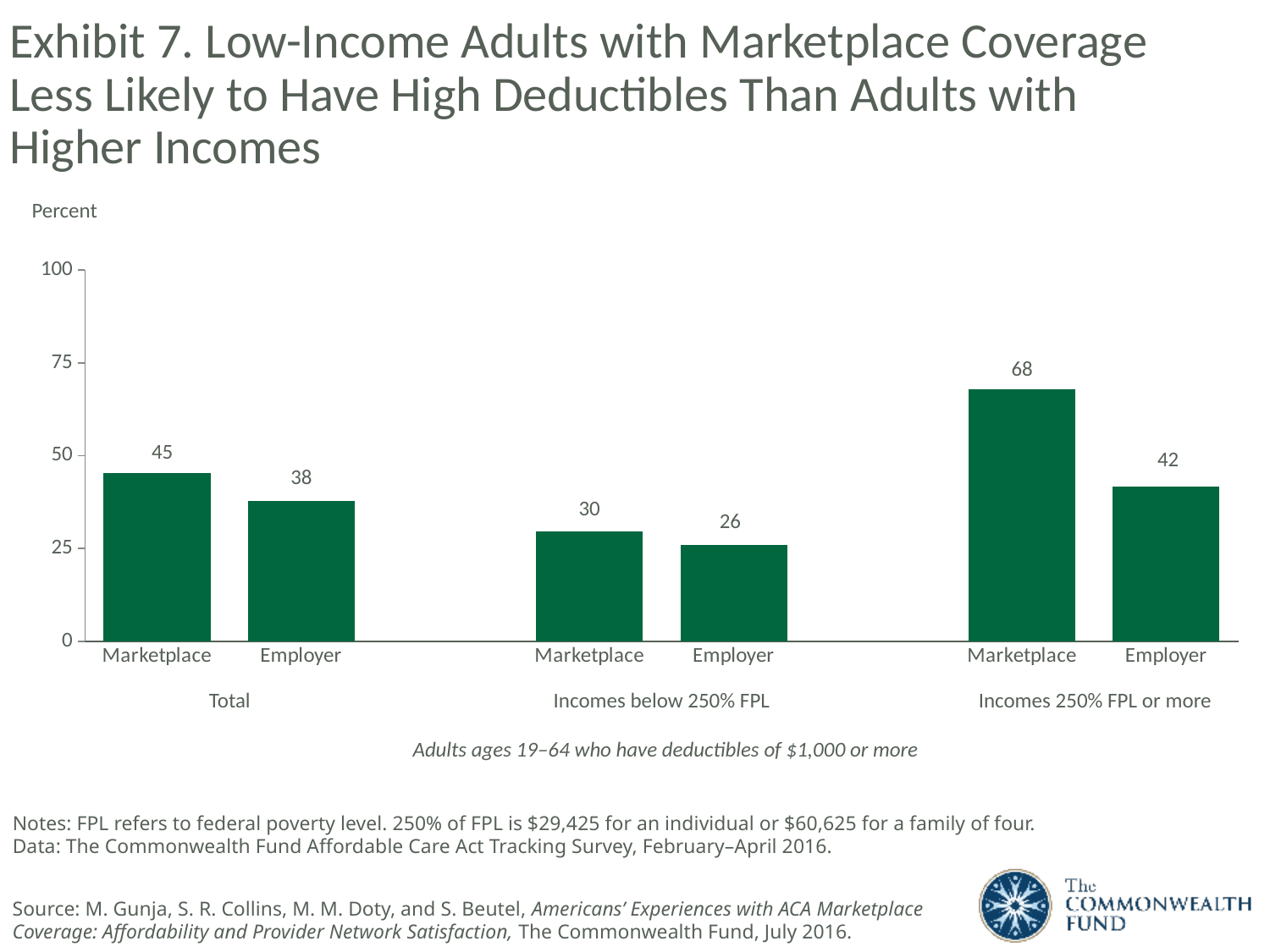
What is the value for Employer among adults with incomes below 250% FPL? 26 What is the difference between the Marketplace and Employer values in the Incomes 250% FPL or more group? 26 What unit is shown on the vertical axis label? Percent Is the value for Marketplace in the Incomes below 250% FPL group greater or less than 50? less What is the difference between the Marketplace values for Incomes 250% FPL or more and Incomes below 250% FPL? 38 How many bars are plotted on the chart? 6 What is the value for Marketplace among adults with incomes 250% FPL or more? 68 Which bar has the lowest value on the chart? Employer, Incomes below 250% FPL What is the value for Marketplace in the Total group? 45 Which is larger: the Employer value in the Total group or the Employer value in the Incomes 250% FPL or more group? Incomes 250% FPL or more Which bar has the highest value on the chart? Marketplace, Incomes 250% FPL or more What type of chart is shown? bar chart